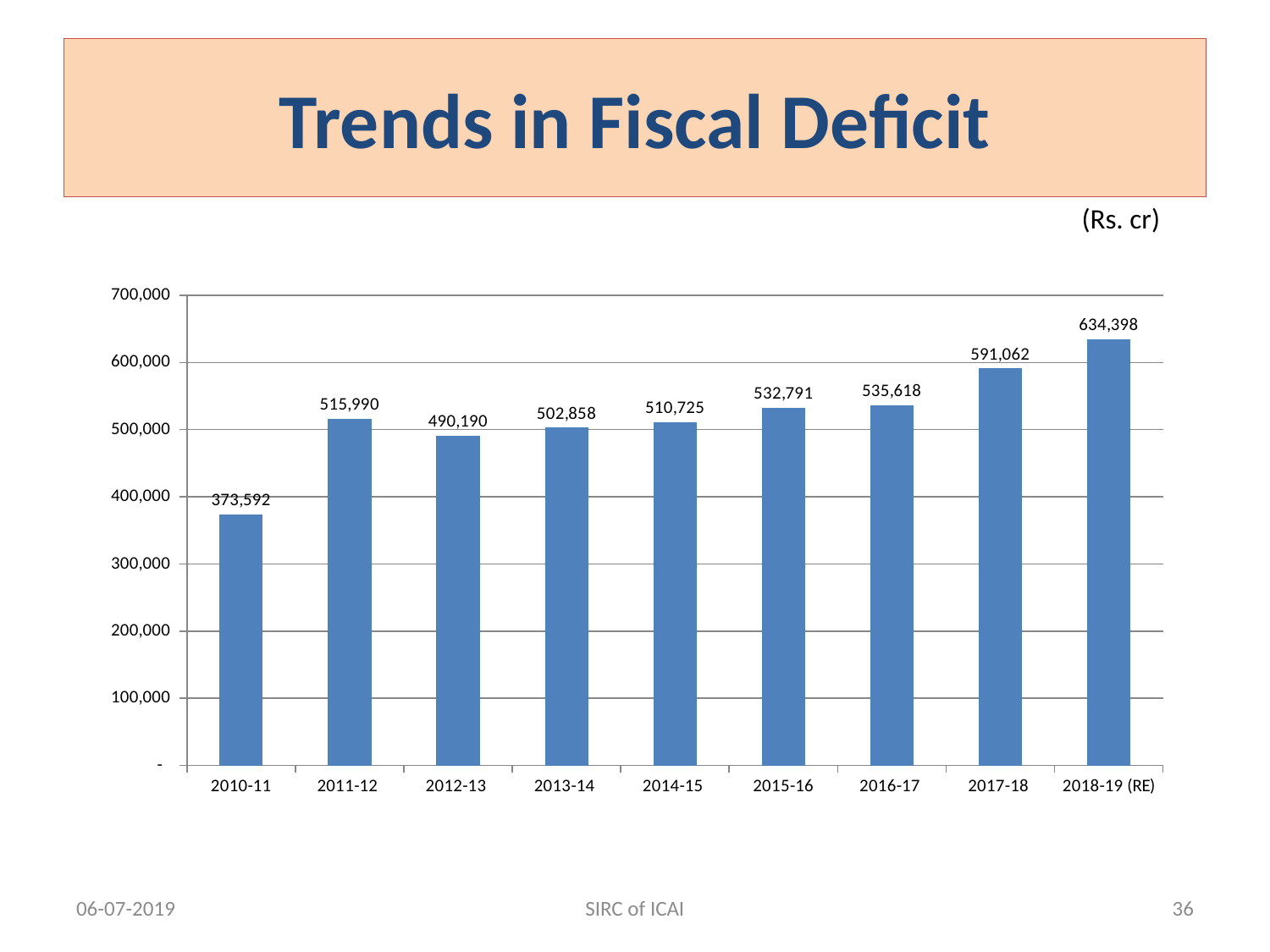
What is the difference between the fiscal deficit in 2018-19 (RE) and 2017-18? 43,336 What is the fiscal deficit value for 2018-19 (RE)? 634,398 How many years are shown on the x axis? 9 What unit is indicated for the values in the chart? Rs. cr What is the fiscal deficit value for 2014-15? 510,725 Which is larger, the fiscal deficit in 2011-12 or in 2013-14? 2011-12 What is the fiscal deficit value for 2010-11? 373,592 Is the value for 2016-17 greater or less than 500,000? greater What is the difference between the fiscal deficit in 2011-12 and 2012-13? 25,800 Which year has the highest fiscal deficit? 2018-19 (RE) What kind of chart is shown on the slide? bar chart Which year has the lowest fiscal deficit? 2010-11